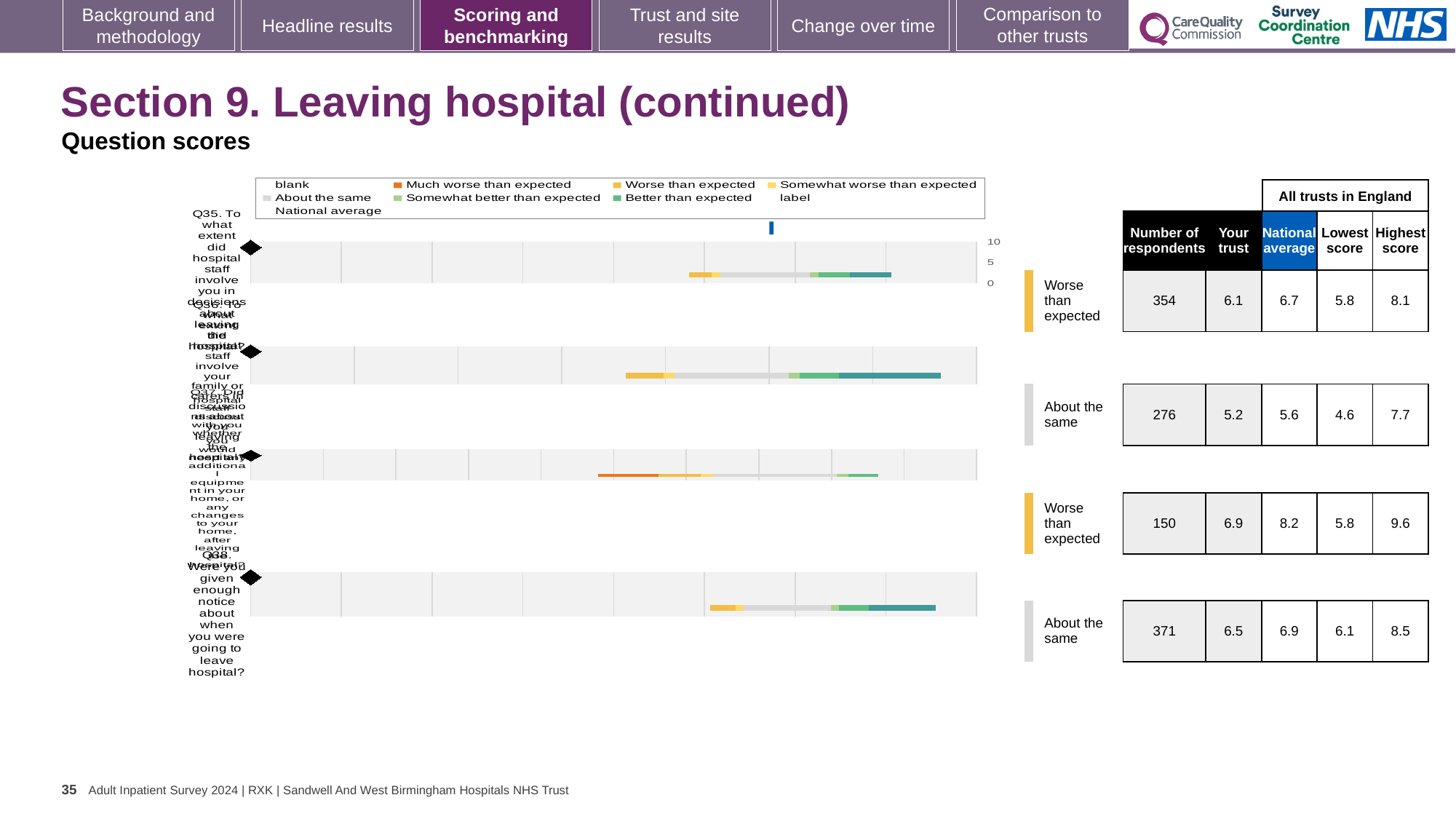
In the first row of the table, is the 'Your trust' score larger or smaller than the national average? smaller In the table, what is the number of respondents for the first row (Q35)? 354 What kind of chart is shown on the slide? bar chart What is the highest 'Your trust' score shown in the table? 6.9 In the table, what is the 'Your trust' score for the last row (Q38)? 6.5 How many entries does the chart legend list? 9 In the table, what is the lowest score among all trusts in England for the second row? 4.6 What is the lowest number of respondents shown in the table? 150 In the first row of the table, what is the difference between the national average (6.7) and the 'Your trust' score (6.1)? 0.6 In the table, what is the highest score among all trusts in England for the third row? 9.6 How many question bars are plotted in the chart? 4 What benchmark label is shown next to the third row of the table? Worse than expected